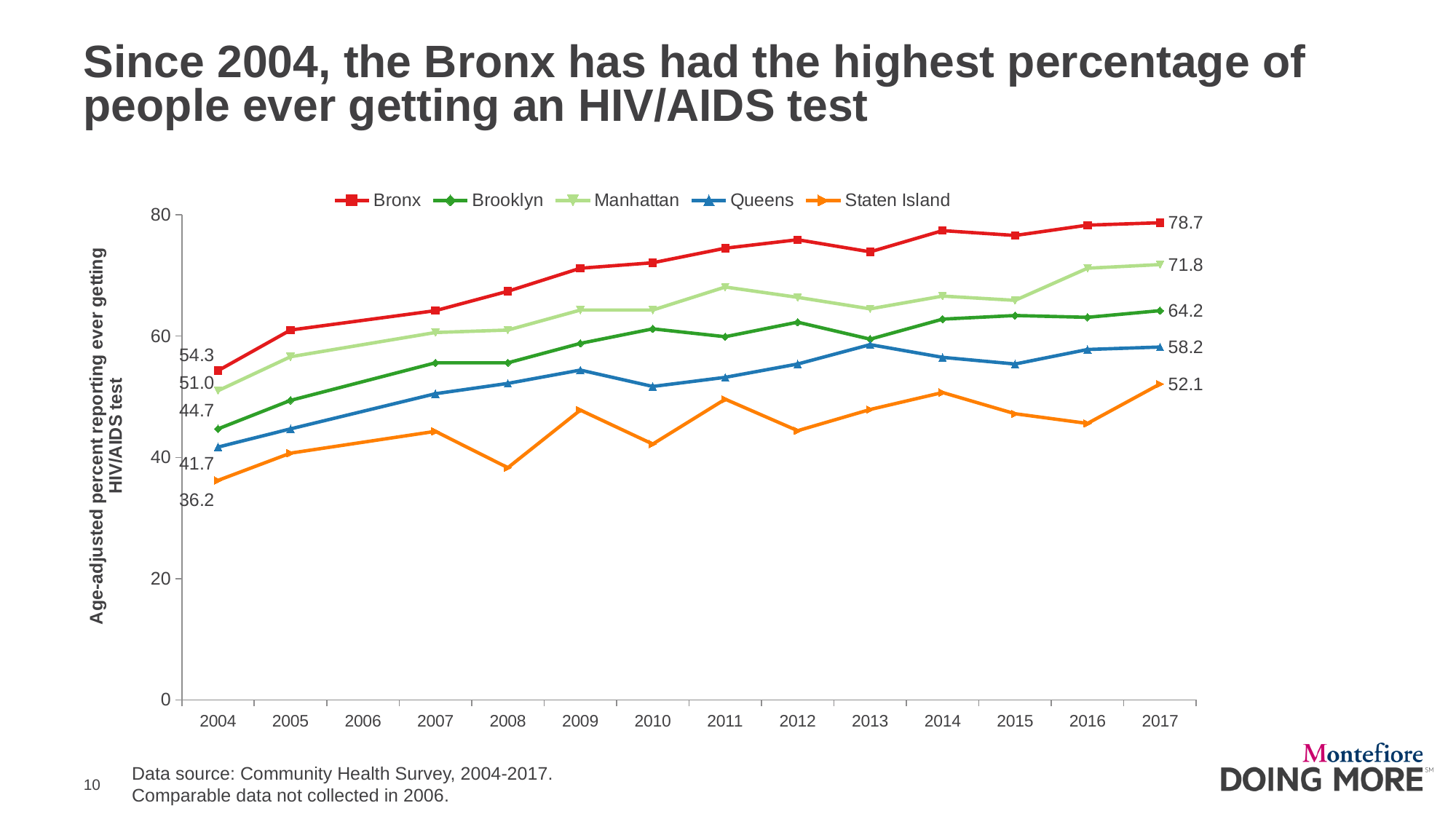
Which borough had the highest value in 2017? Bronx What kind of chart is shown on the slide? line chart What is the difference between the Bronx and Staten Island values in 2017? 26.6 In 2017, which was larger: Brooklyn's value or Queens's value? Brooklyn Which borough had the lowest value in 2004? Staten Island How many series does the legend list? 5 What was Queens's value in 2004? 41.7 What was Staten Island's value in 2004? 36.2 What was Manhattan's value in 2017? 71.8 By how much did the Bronx's value increase from 2004 to 2017? 24.4 What was the Bronx's age-adjusted percent reporting ever getting an HIV/AIDS test in 2017? 78.7 Is the value for Queens in 2010 greater or less than 60? less